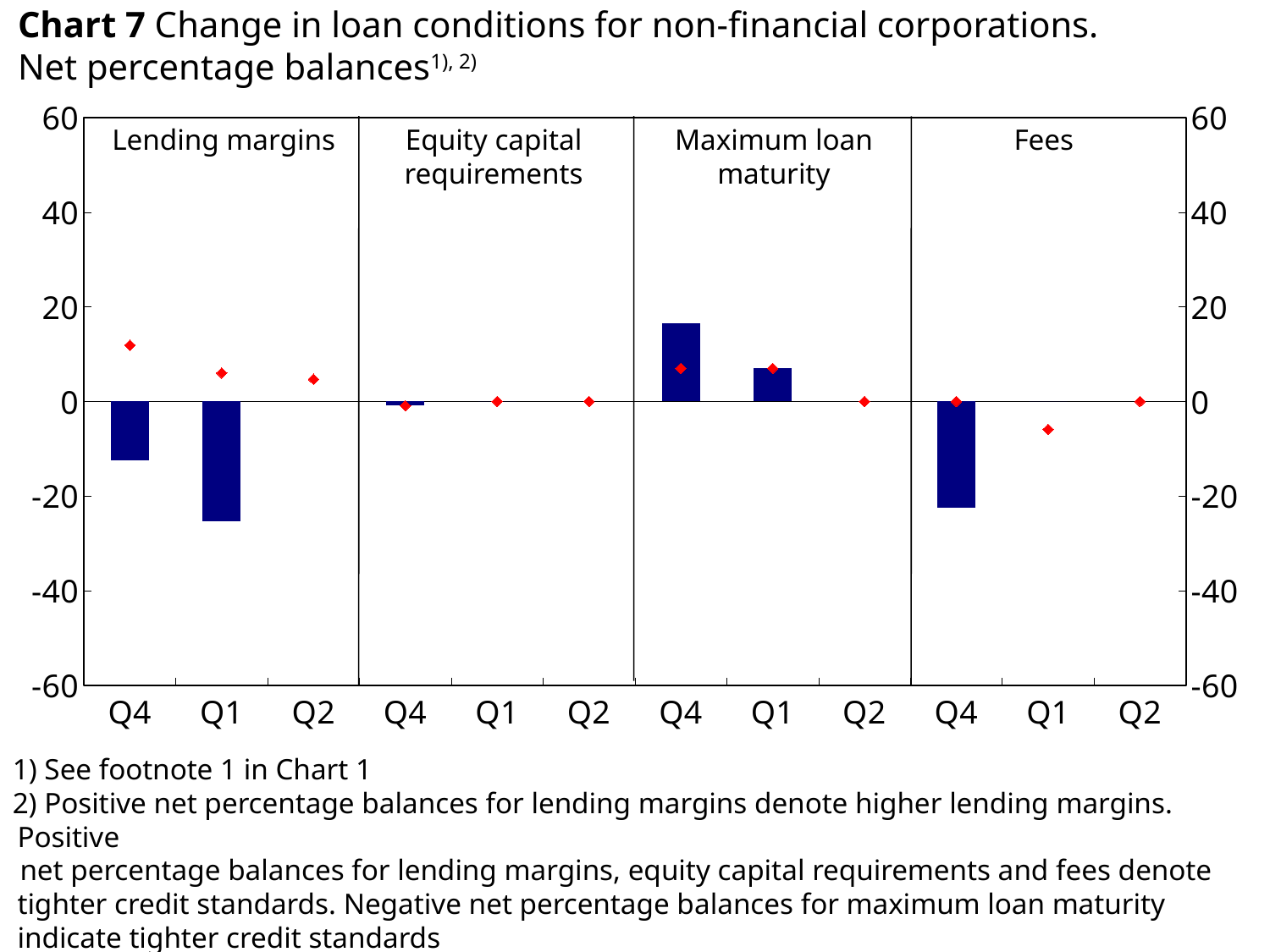
In the Lending margins panel, is the bar value for Q4 greater or less than -20? greater In the Fees panel, is the bar value for Q4 greater or less than -20? less Which panel has the highest positive bar in Chart 7? Maximum loan maturity In the Lending margins panel, do the red diamond markers rise or fall from Q4 to Q2? fall What kind of chart is Chart 7? combination bar and line chart (bars with diamond markers) In the Lending margins panel, is the bar value for Q1 greater or less than -20? less Which panel contains the lowest bar in Chart 7? Lending margins How many quarters are shown on the x axis of each panel in Chart 7? 3 In the Maximum loan maturity panel, which bar is larger, Q4 or Q1? Q4 What is the maximum value shown on the vertical axis of Chart 7? 60 How many loan condition panels are shown in Chart 7? 4